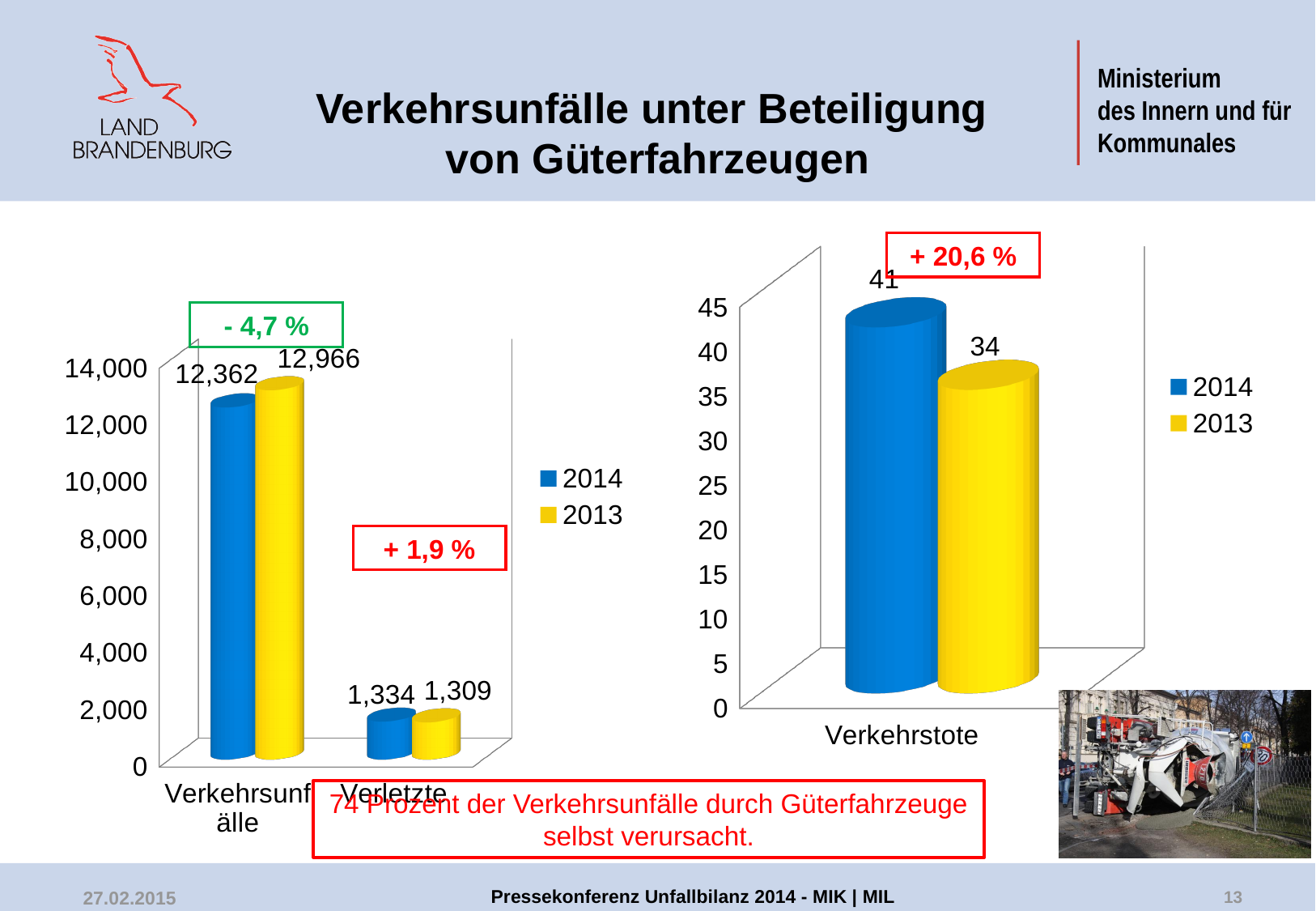
In the left chart, what is the difference between the 2013 and 2014 values for Verkehrsunfälle? 604 In the left chart, what is the value for Verletzte in 2014? 1,334 In the left chart, which year has the larger value for Verkehrsunfälle, 2014 or 2013? 2013 In the right chart, what is the value for Verkehrstote in 2013? 34 In the right chart, what is the difference between the 2014 and 2013 values for Verkehrstote? 7 In the left chart, what is the value for Verkehrsunfälle in 2014? 12,362 What kind of chart is the right chart? Bar chart In the left chart, which year has the larger value for Verletzte, 2014 or 2013? 2014 In the left chart, what is the value for Verkehrsunfälle in 2013? 12,966 In the right chart, what is the value for Verkehrstote in 2014? 41 How many categories are shown on the x axis of the left chart? 2 How many series does the legend of the right chart list? 2